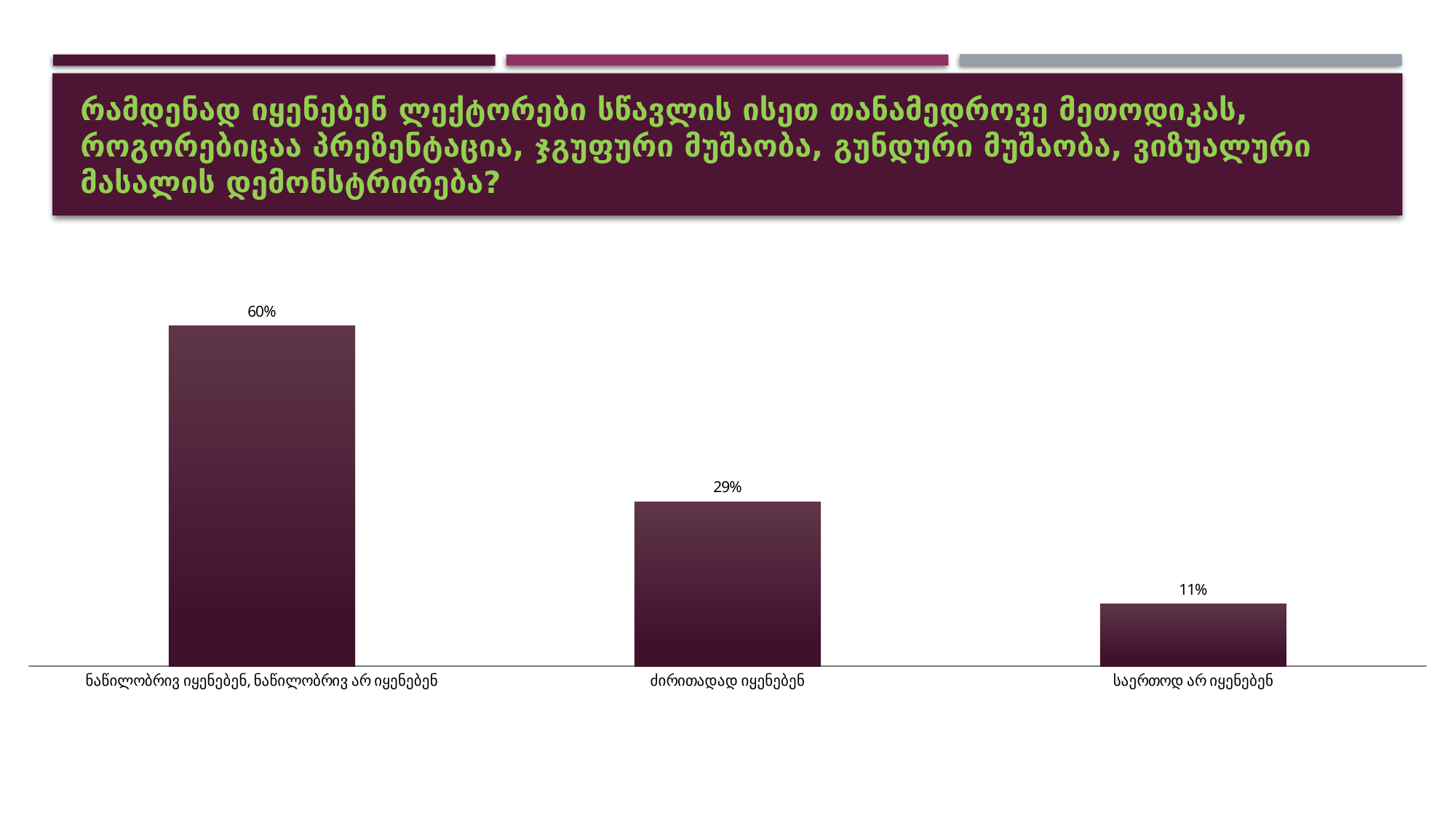
Do the values rise or fall from left to right across the categories? Fall What is the total of the three values shown in the chart? 100% What is the value for "საერთოდ არ იყენებენ"? 11% How many categories are shown in the chart? 3 What is the difference between the values for "ნაწილობრივ იყენებენ, ნაწილობრივ არ იყენებენ" and "ძირითადად იყენებენ"? 31% What is the value for "ნაწილობრივ იყენებენ, ნაწილობრივ არ იყენებენ"? 60% What is the difference between the values for "ძირითადად იყენებენ" and "საერთოდ არ იყენებენ"? 18% Which category has the lowest value? საერთოდ არ იყენებენ What is the value for "ძირითადად იყენებენ"? 29% What kind of chart is shown on the slide? Bar chart Which category has the highest value? ნაწილობრივ იყენებენ, ნაწილობრივ არ იყენებენ Which is larger: the value for "ძირითადად იყენებენ" or the value for "საერთოდ არ იყენებენ"? ძირითადად იყენებენ